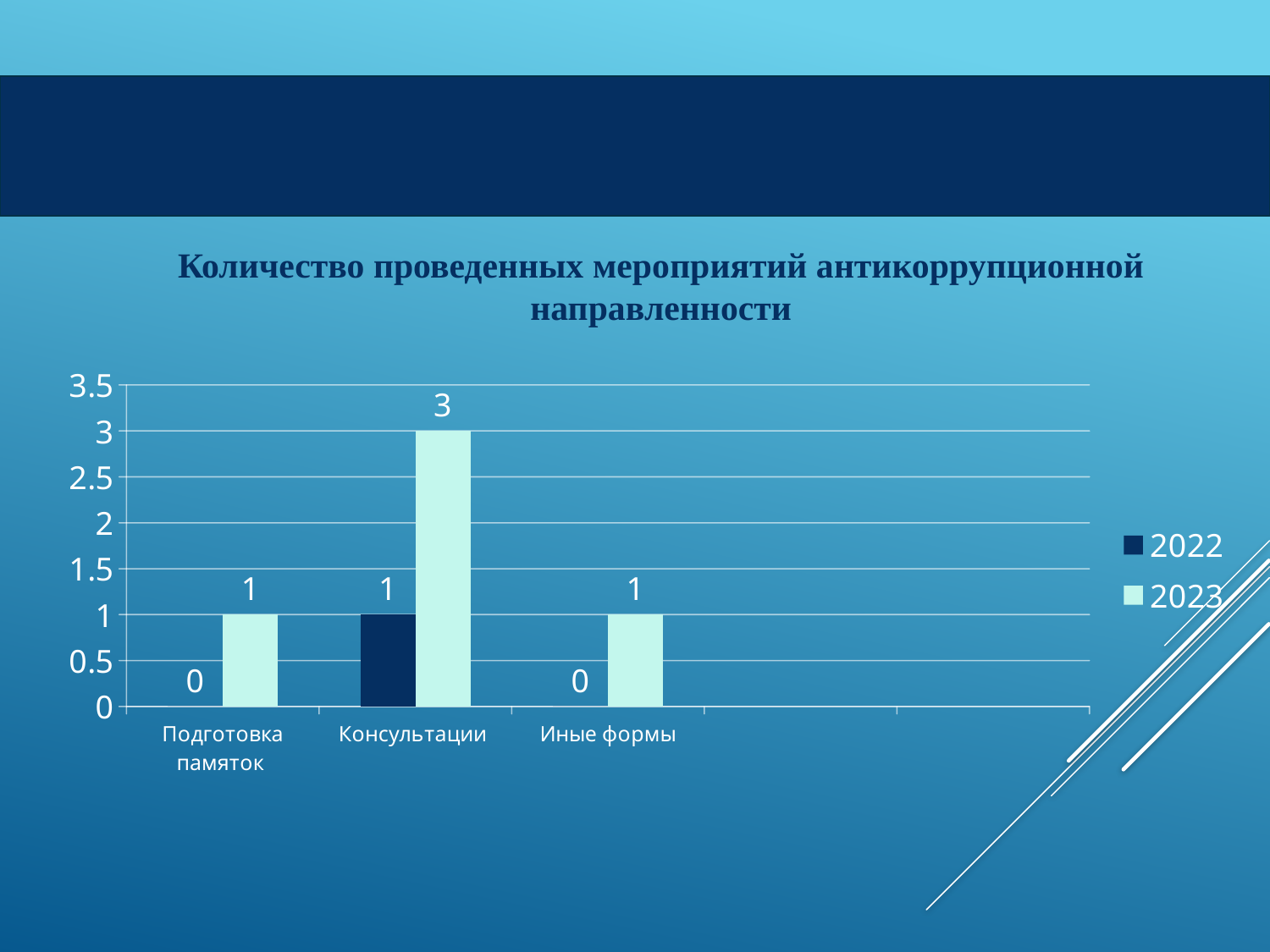
How many series does the legend list? 2 What is the value for 2023 in the Иные формы category? 1 What kind of chart is shown on the slide? Bar chart Which is larger for Консультации: the 2022 value or the 2023 value? 2023 Which series is shown in dark blue in the legend? 2022 How many categories are shown on the x axis? 3 What is the value for 2022 in the Консультации category? 1 What is the value for 2023 in the Консультации category? 3 What is the difference between the 2023 and 2022 values for Консультации? 2 Which category has the highest value for 2023? Консультации What is the value for 2022 in the Подготовка памяток category? 0 What is the title of the chart? Количество проведенных мероприятий антикоррупционной направленности